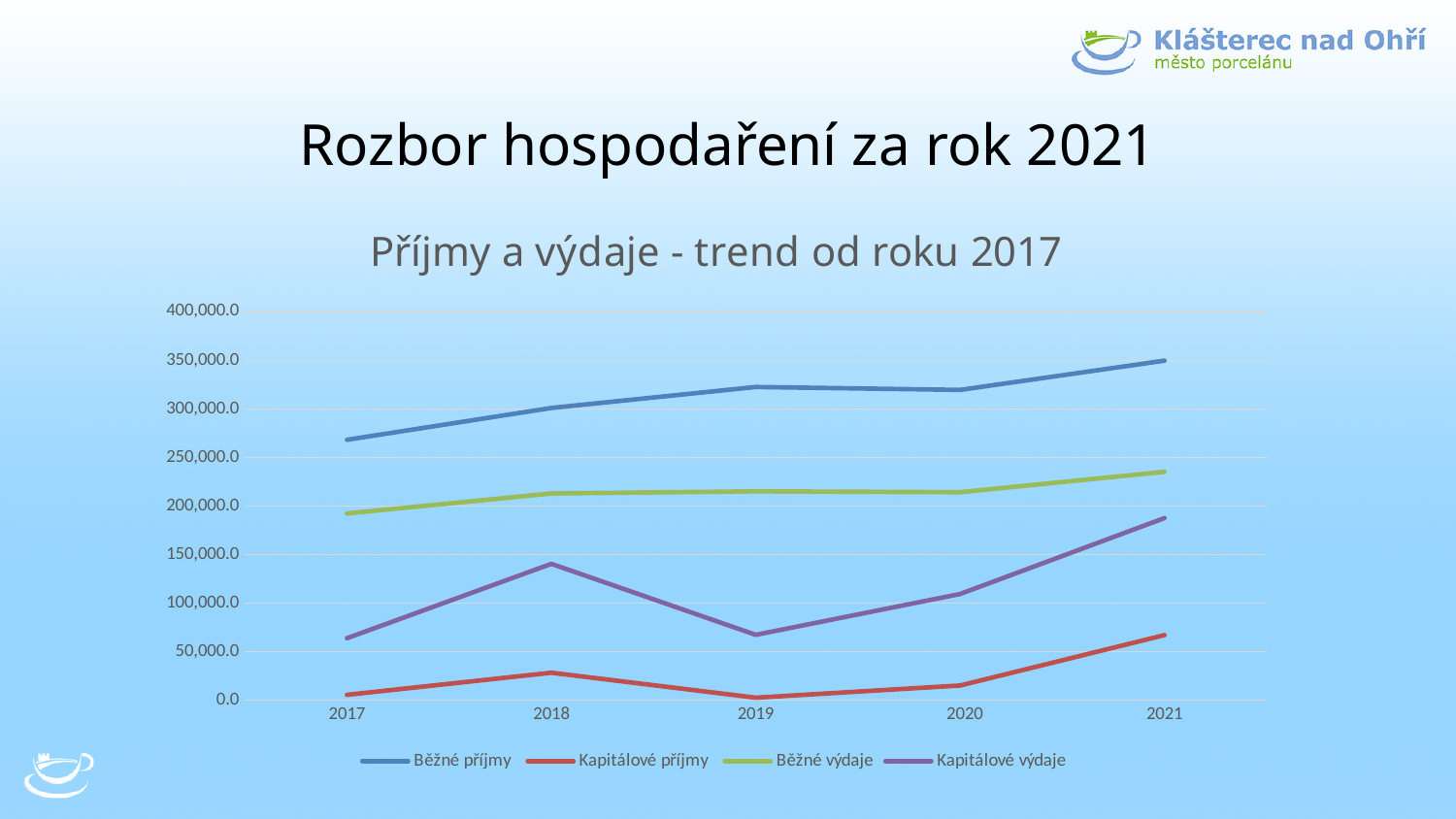
In which year is Běžné příjmy lowest? 2017 How many series does the legend list? 4 Do the values for Běžné výdaje rise or fall from 2017 to 2021? rise In which year is Kapitálové příjmy highest? 2021 What kind of chart is shown on the slide? line chart In which year is Kapitálové výdaje highest? 2021 Is the value for Kapitálové příjmy in 2018 greater or less than 50,000.0? less In 2019, which is larger: Kapitálové výdaje or Kapitálové příjmy? Kapitálové výdaje How many years are plotted along the x axis? 5 Is the value for Běžné příjmy in 2021 greater or less than 300,000.0? greater What is the title of the chart? Příjmy a výdaje - trend od roku 2017 Is the value for Kapitálové výdaje in 2018 greater or less than 100,000.0? greater